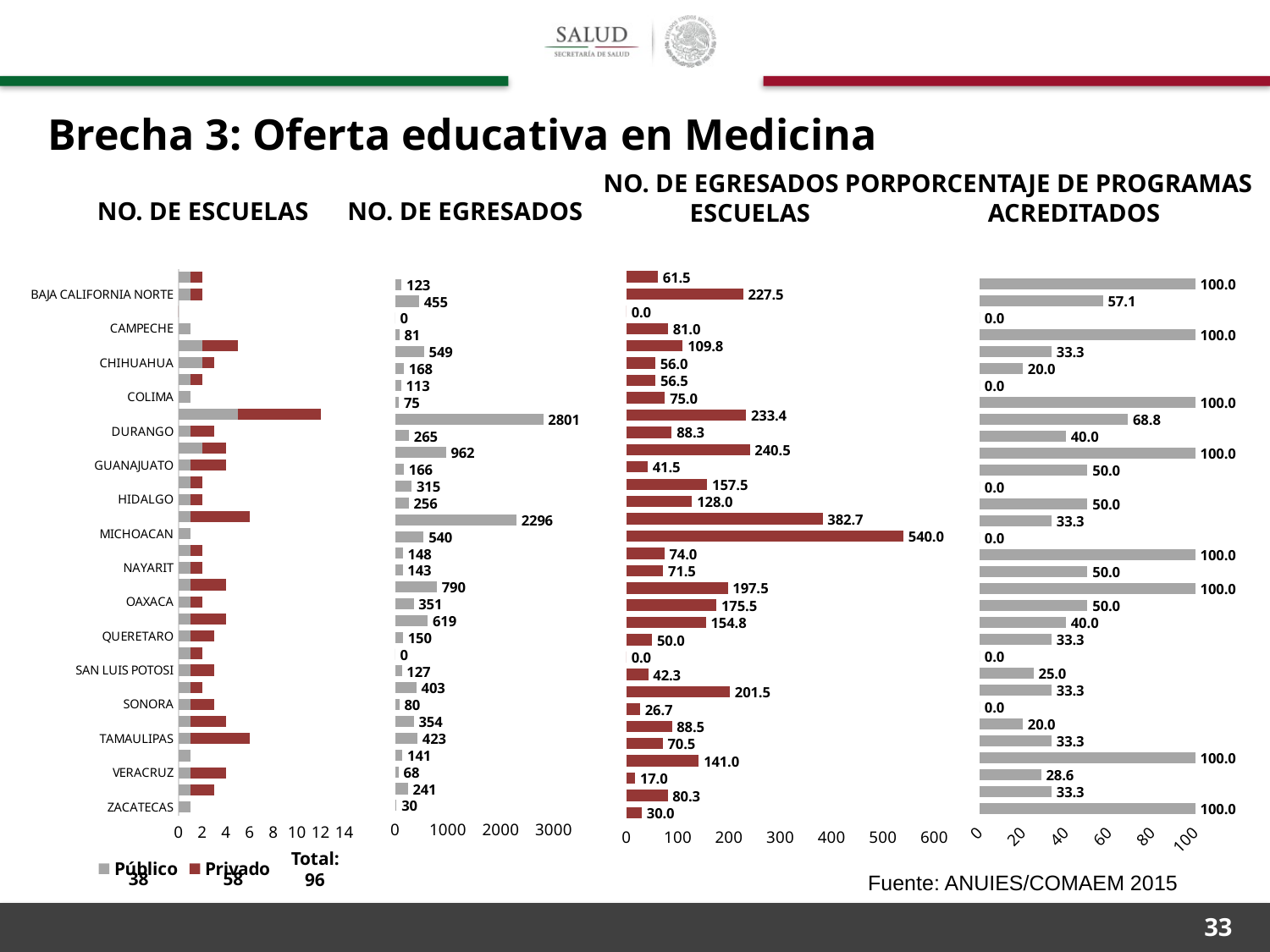
In the NO. DE EGRESADOS POR ESCUELAS chart, what is the difference between the two largest values, 540.0 and 382.7? 157.3 In the NO. DE EGRESADOS chart, what is the highest value shown? 2801 What source is cited at the bottom of the slide for the charts? ANUIES/COMAEM 2015 How many series does the legend of the NO. DE ESCUELAS chart list? 2 In the PORCENTAJE DE PROGRAMAS ACREDITADOS chart, what is the highest value shown? 100.0 In the NO. DE ESCUELAS chart, what total is given for Privado in the legend? 58 In the PORCENTAJE DE PROGRAMAS ACREDITADOS chart, how many bars have the value 100.0? 8 What kind of chart is the NO. DE ESCUELAS chart? bar chart In the NO. DE ESCUELAS chart, what total is given for Público in the legend? 38 In the NO. DE ESCUELAS chart, what total is shown below the legend? 96 In the NO. DE EGRESADOS chart, what is the difference between the two largest values, 2801 and 2296? 505 In the NO. DE EGRESADOS POR ESCUELAS chart, what is the highest value shown? 540.0